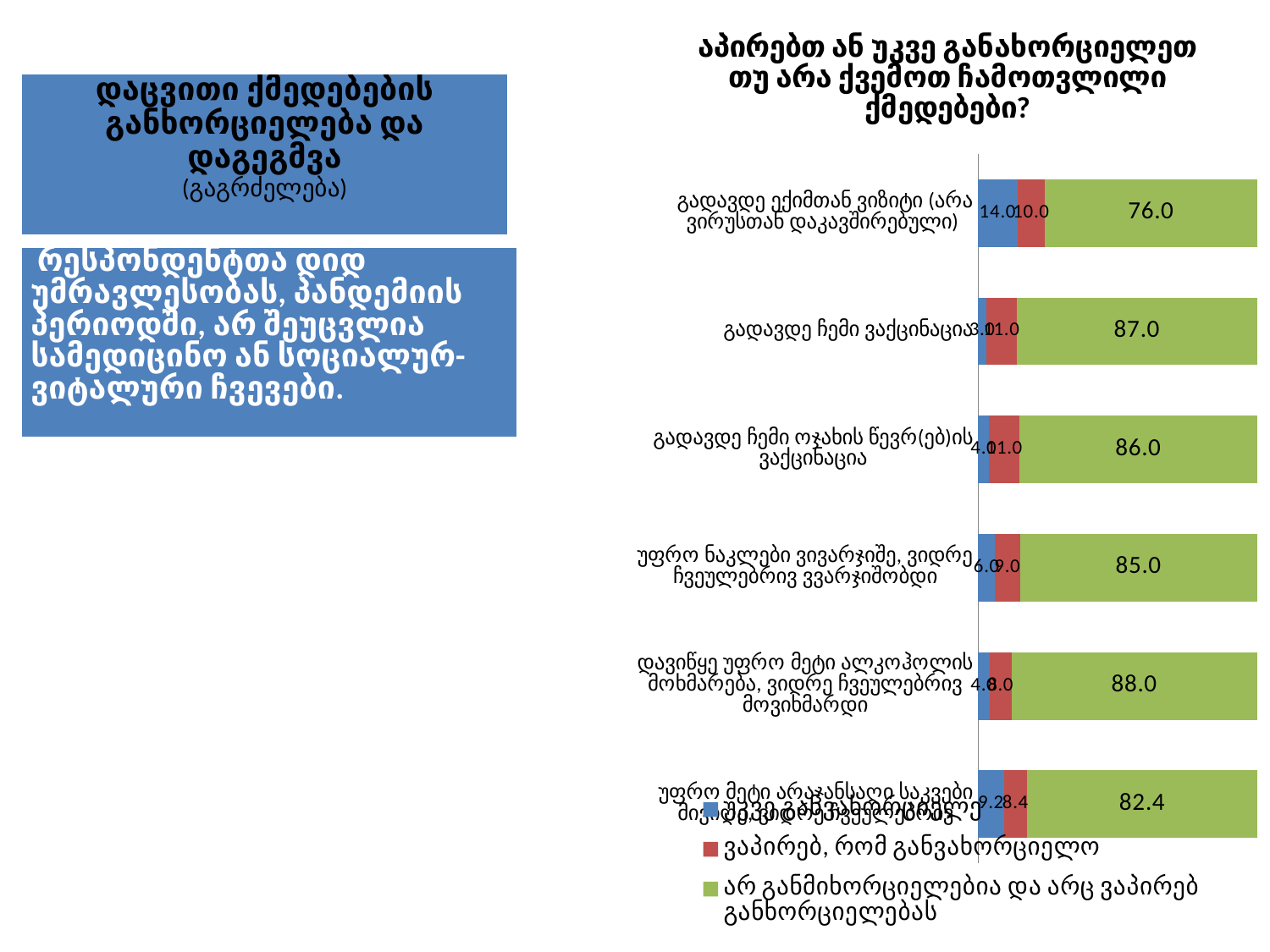
Which category has the lowest value in the green series? გადავდე ექიმთან ვიზიტი (არა ვირუსთან დაკავშირებული) How many series does the chart legend list? 3 What is the value of the green series for 'უფრო მეტი არაჯანსაღი საკვები მივიღე'? 82.4 In the green series, which is larger: 'გადავდე ჩემი ვაქცინაცია' or 'გადავდე ჩემი ოჯახის წევრ(ებ)ის ვაქცინაცია'? გადავდე ჩემი ვაქცინაცია How many categories are plotted in the chart? 6 What is the total of the stacked bar for 'გადავდე ექიმთან ვიზიტი (არა ვირუსთან დაკავშირებული)'? 100.0 What kind of chart is shown on the slide? bar chart Which category has the highest value in the green series? დავიწყე უფრო მეტი ალკოჰოლის მოხმარება, ვიდრე ჩვეულებრივ მოვიხმარდი What is the value of the blue series for 'გადავდე ექიმთან ვიზიტი (არა ვირუსთან დაკავშირებული)'? 14.0 What is the value of the green series for 'გადავდე ჩემი ვაქცინაცია'? 87.0 What is the difference between the highest (88.0) and lowest (76.0) values in the green series? 12.0 What is the value of the green series (არ განმიხორციელებია და არც ვაპირებ განხორციელებას) for 'გადავდე ექიმთან ვიზიტი (არა ვირუსთან დაკავშირებული)'? 76.0